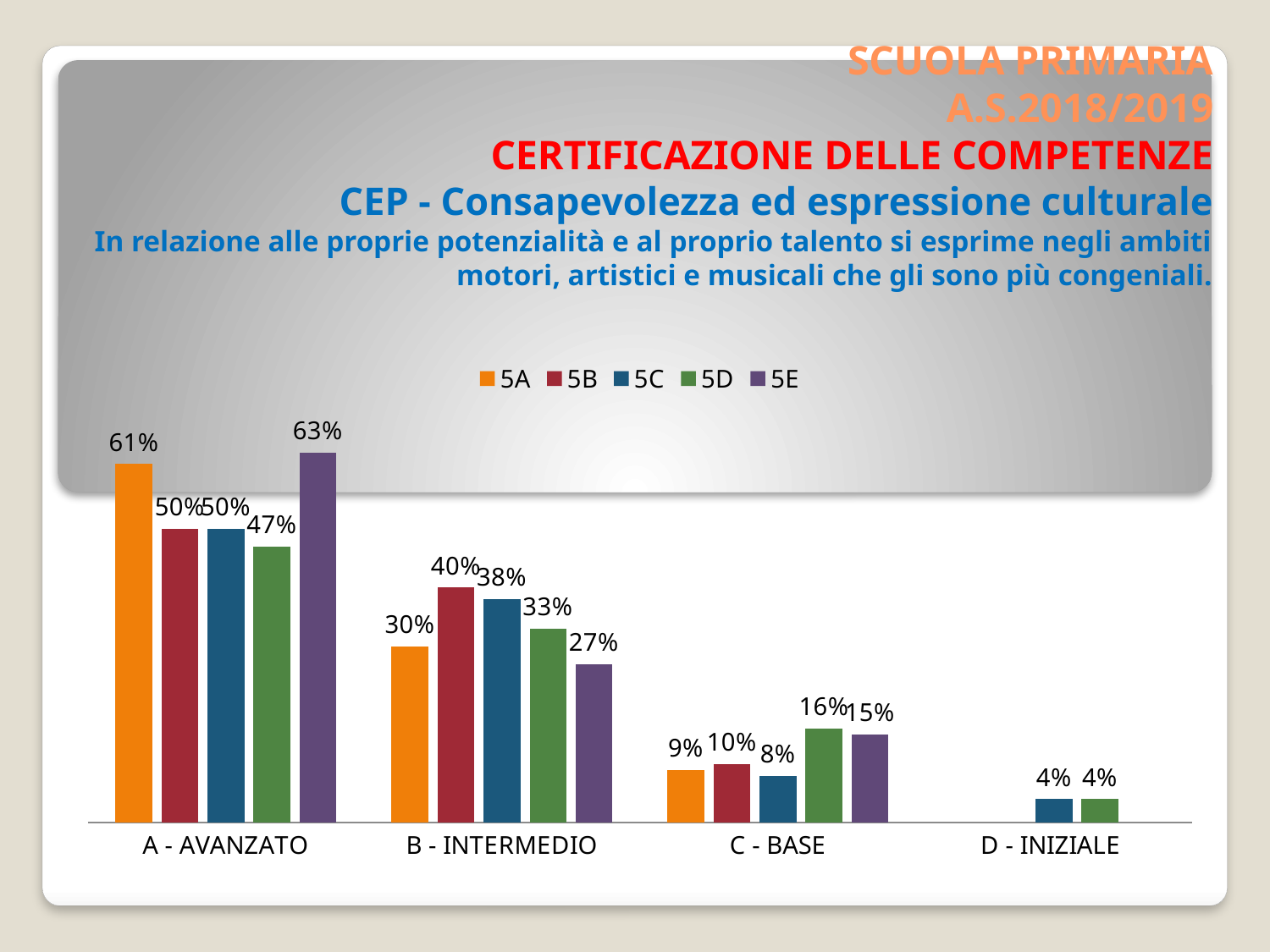
Which series has the highest value in the A - AVANZATO category? 5E What is the value for 5A in the B - INTERMEDIO category? 30% What is the value for 5D in the C - BASE category? 16% In the C - BASE category, which is larger: the value for 5D or the value for 5A? 5D What is the value for 5C in the D - INIZIALE category? 4% How many series does the legend list? 5 What kind of chart is shown on the slide? Bar chart What is the value for 5E in the A - AVANZATO category? 63% Which colour represents the 5A series in the legend? Orange Which series has the lowest value in the B - INTERMEDIO category? 5E How many categories are shown on the x axis? 4 What is the difference between the 5B and 5A values in the B - INTERMEDIO category? 10%